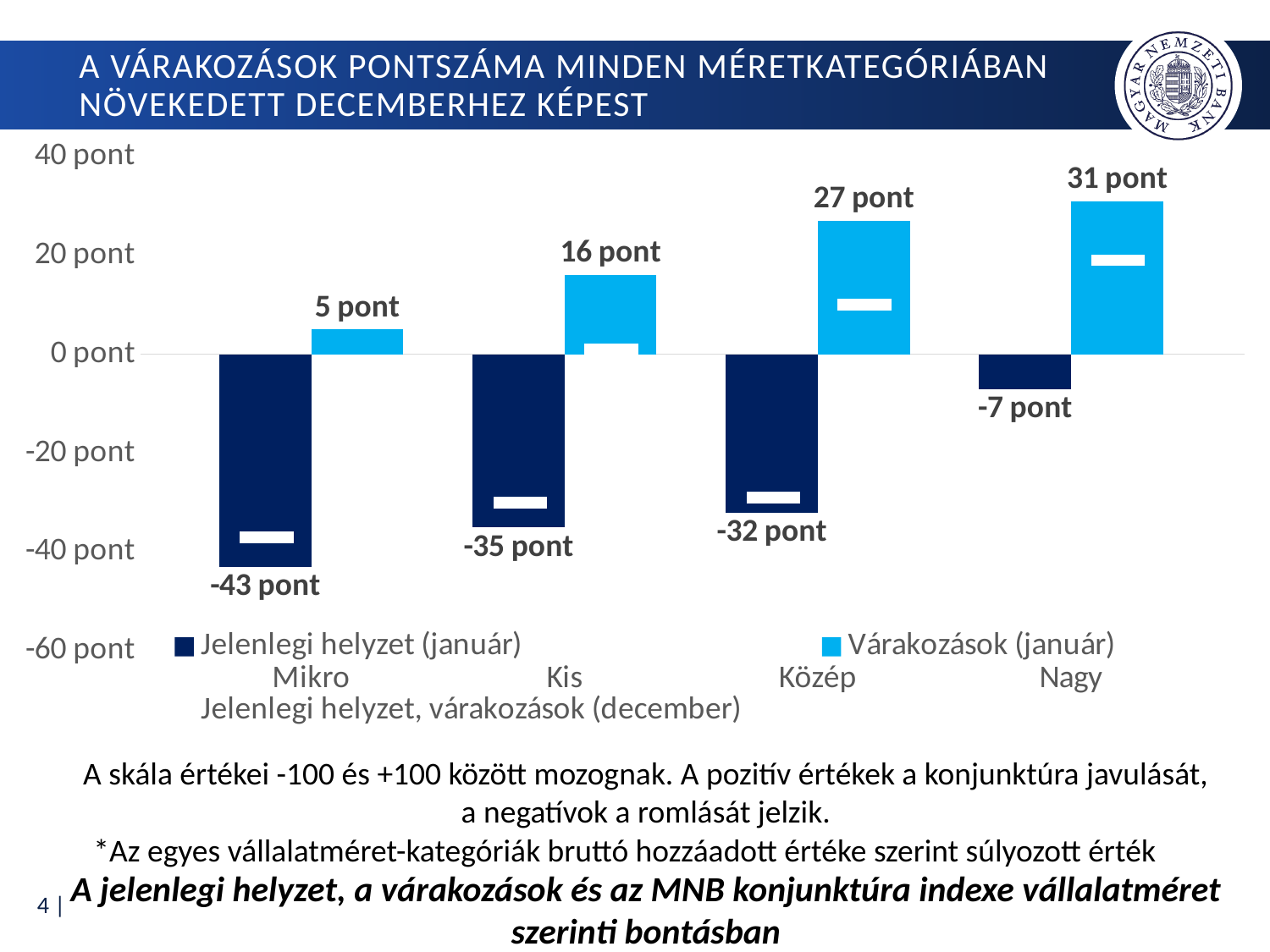
Which is larger, the Várakozások (január) value for Kis or for Közép? Közép Which category has the lowest Jelenlegi helyzet (január) value? Mikro How many size categories are shown on the x axis? 4 What is the value of Várakozások (január) for Közép? 27 pont Do the Várakozások (január) values rise or fall from Mikro to Nagy? Rise What is the value of Jelenlegi helyzet (január) for Mikro? -43 pont How many entries does the legend list? 3 What is the difference between the Várakozások (január) values for Nagy and Mikro? 26 pont Which category has the highest Várakozások (január) value? Nagy What is the value of Jelenlegi helyzet (január) for Nagy? -7 pont What kind of chart is shown on the slide? Bar chart What is the value of Várakozások (január) for Kis? 16 pont